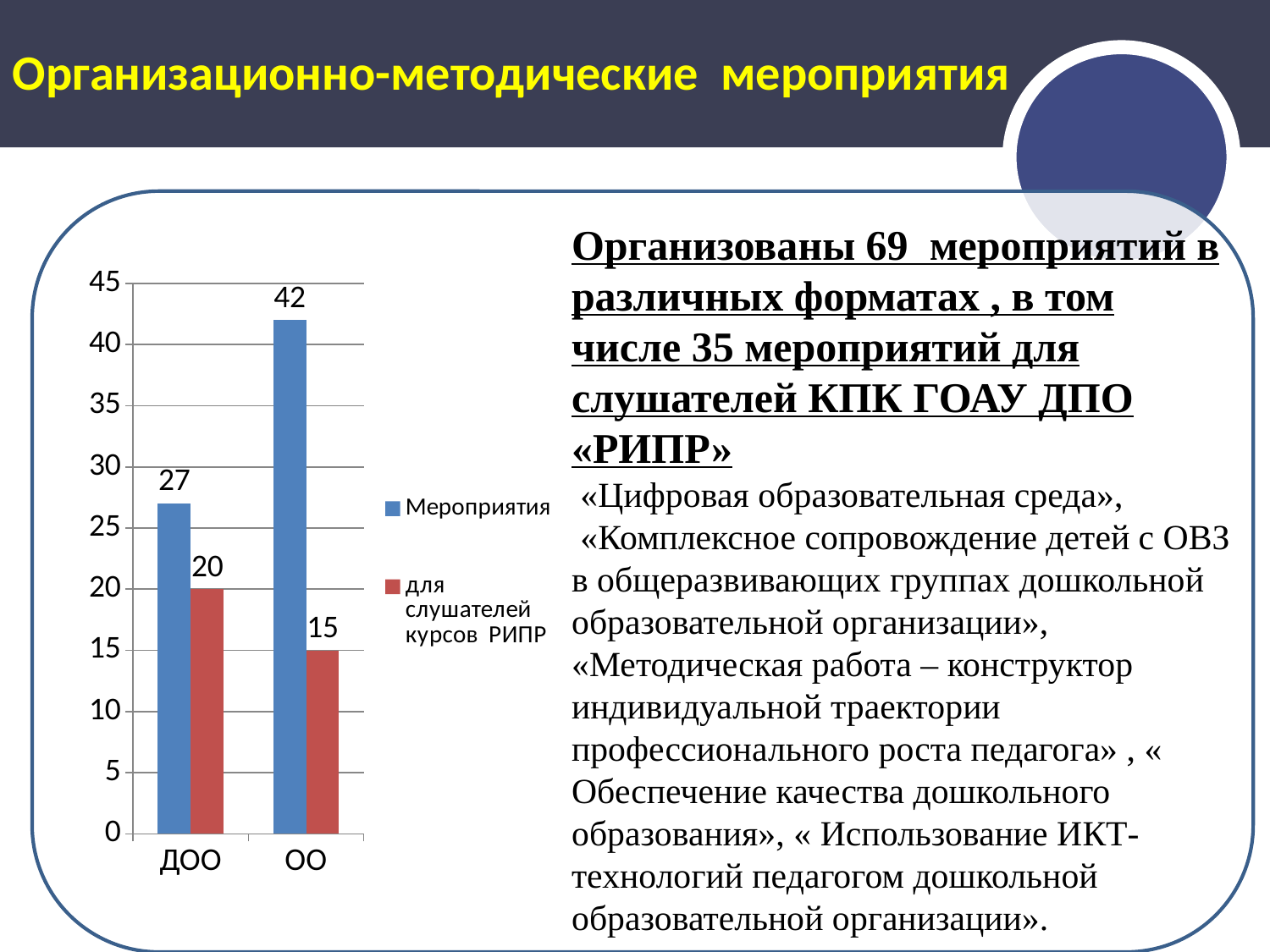
Which is larger: Мероприятия for ДОО or 'для слушателей курсов РИПР' for ДОО? Мероприятия for ДОО What kind of chart is shown on the slide? bar chart What is the value of Мероприятия for ОО? 42 What is the value of Мероприятия for ДОО? 27 How many series does the legend list? 2 Which category has the lowest value for 'для слушателей курсов РИПР'? ОО What is the difference between the Мероприятия values for ОО and ДОО? 15 What is the value of 'для слушателей курсов РИПР' for ДОО? 20 How many categories are shown on the x axis? 2 What is the value of 'для слушателей курсов РИПР' for ОО? 15 What colour are the bars for the Мероприятия series? blue Which category has the highest value for Мероприятия? ОО